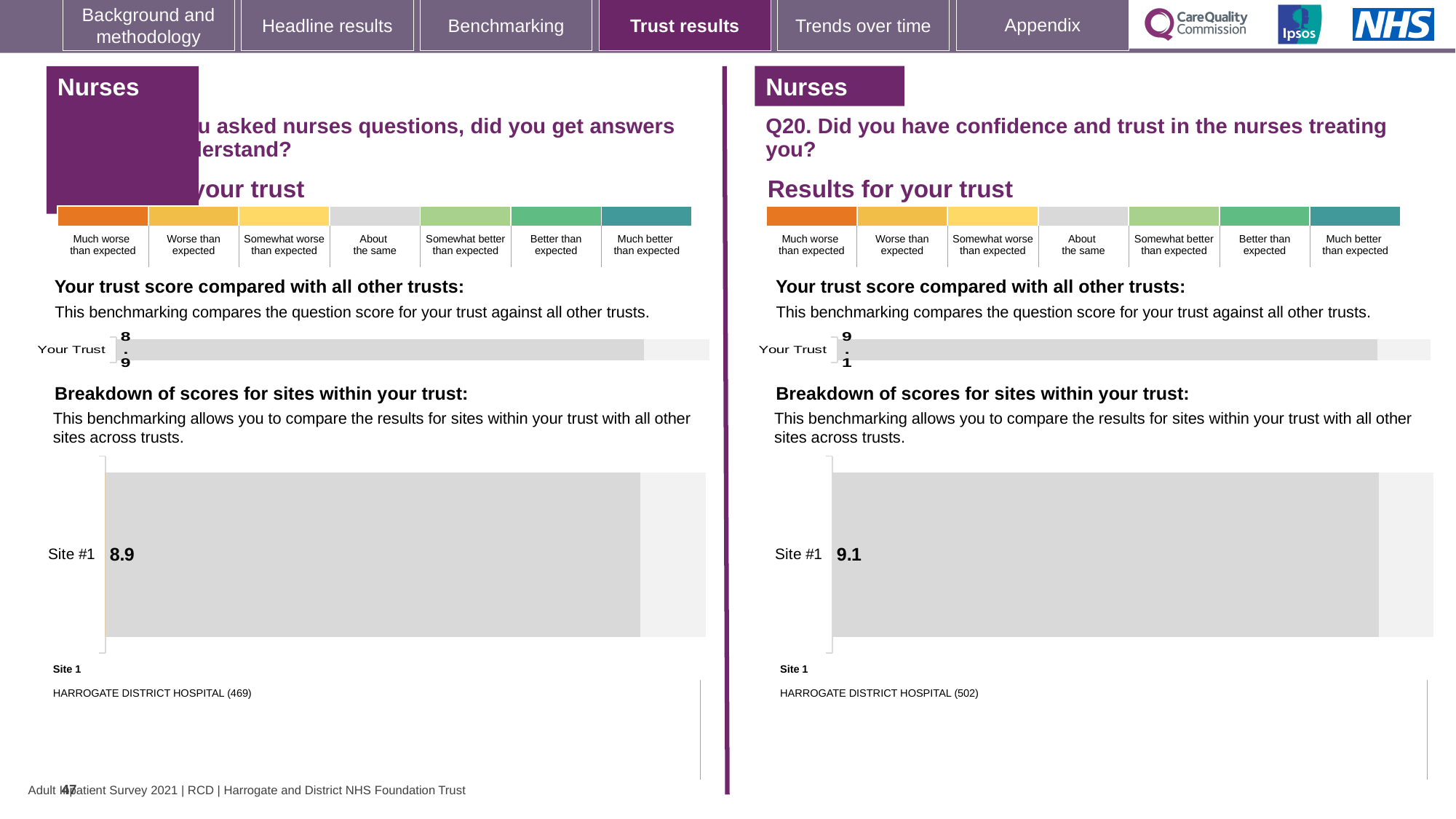
What type of chart is used to show the Your Trust score on the left-hand side of the slide? Bar chart Which is larger: the Your Trust score on the left-hand side of the slide or the Your Trust score on the right-hand side (Q20)? Right-hand side (Q20) What type of chart is used to show the Site #1 score on the right-hand side of the slide (Q20)? Bar chart How many sites are shown in the left-hand 'Breakdown of scores for sites within your trust' chart? 1 On the right-hand side (Q20), what is the score shown for Your Trust in the 'Your trust score compared with all other trusts' chart? 9.1 In the right-hand 'Breakdown of scores for sites within your trust' chart (Q20), what is the score for Site #1? 9.1 How many sites are shown in the right-hand 'Breakdown of scores for sites within your trust' chart (Q20)? 1 On the left-hand side of the slide, what is the score shown for Your Trust in the 'Your trust score compared with all other trusts' chart? 8.9 What is the difference between the Site #1 score on the right-hand side (Q20) and the Site #1 score on the left-hand side? 0.2 Which hospital is listed as Site 1 beneath the left-hand breakdown chart? HARROGATE DISTRICT HOSPITAL (469) In the left-hand 'Breakdown of scores for sites within your trust' chart, what is the score for Site #1? 8.9 Which hospital is listed as Site 1 beneath the right-hand breakdown chart (Q20)? HARROGATE DISTRICT HOSPITAL (502)